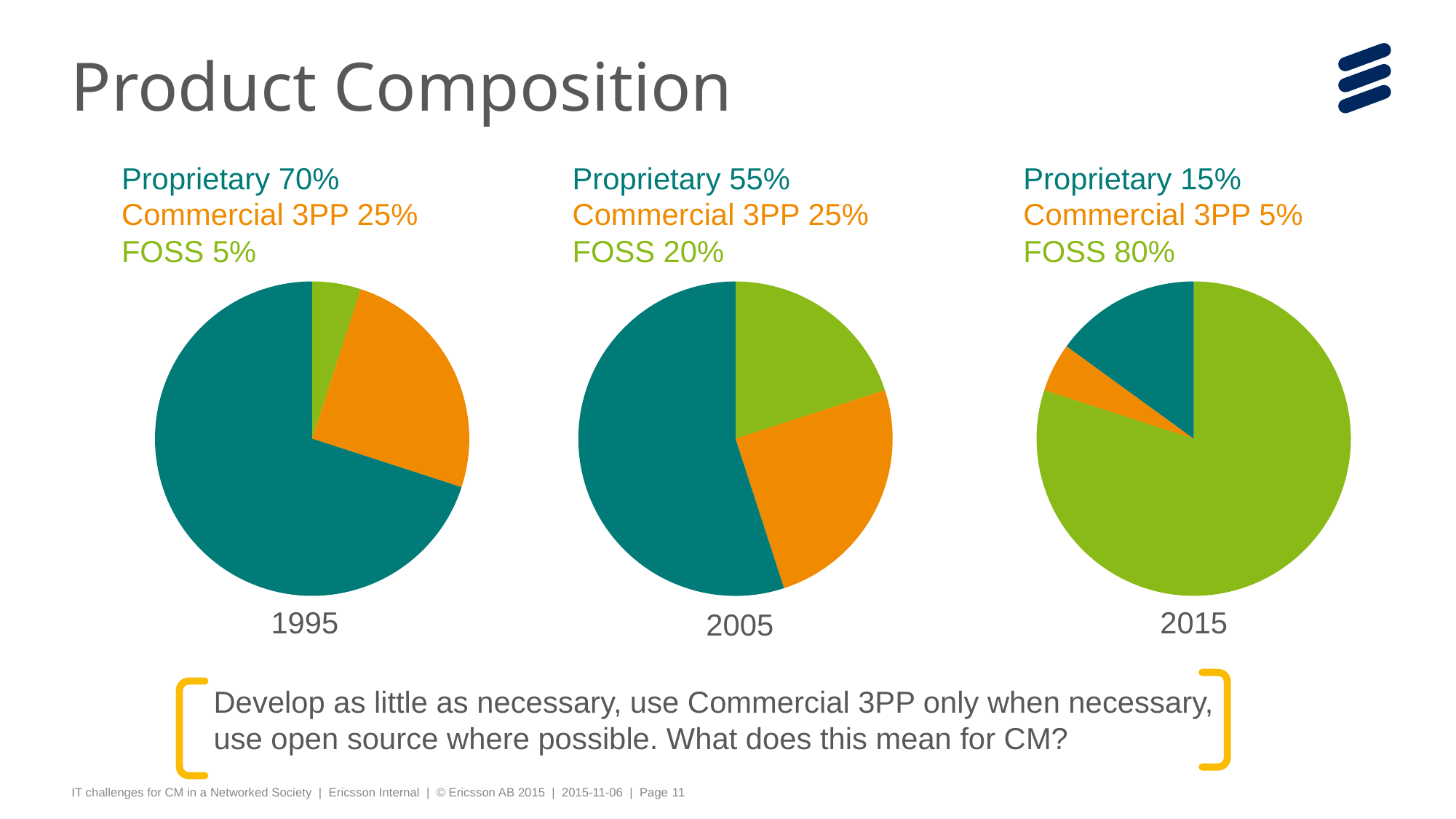
How many slices does each pie chart on the slide have? 3 In the 2015 pie chart, which category has the largest slice? FOSS In the 2015 pie chart, what share does Commercial 3PP have? 5% In the 1995 pie chart, which category has the smallest slice? FOSS In the 2005 pie chart, what is the difference between the Proprietary share and the Commercial 3PP share? 30% In the 2015 pie chart, which is larger, the Proprietary slice or the Commercial 3PP slice? Proprietary Across the 1995, 2005 and 2015 pie charts, does the FOSS share rise or fall over time? Rise What kind of chart is used for the 1995 product composition? Pie chart In the 2005 pie chart, what share does FOSS have? 20% How many pie charts are shown on the slide? 3 In the 2005 pie chart, which category has the largest slice? Proprietary In the 1995 pie chart, what share does Proprietary have? 70%